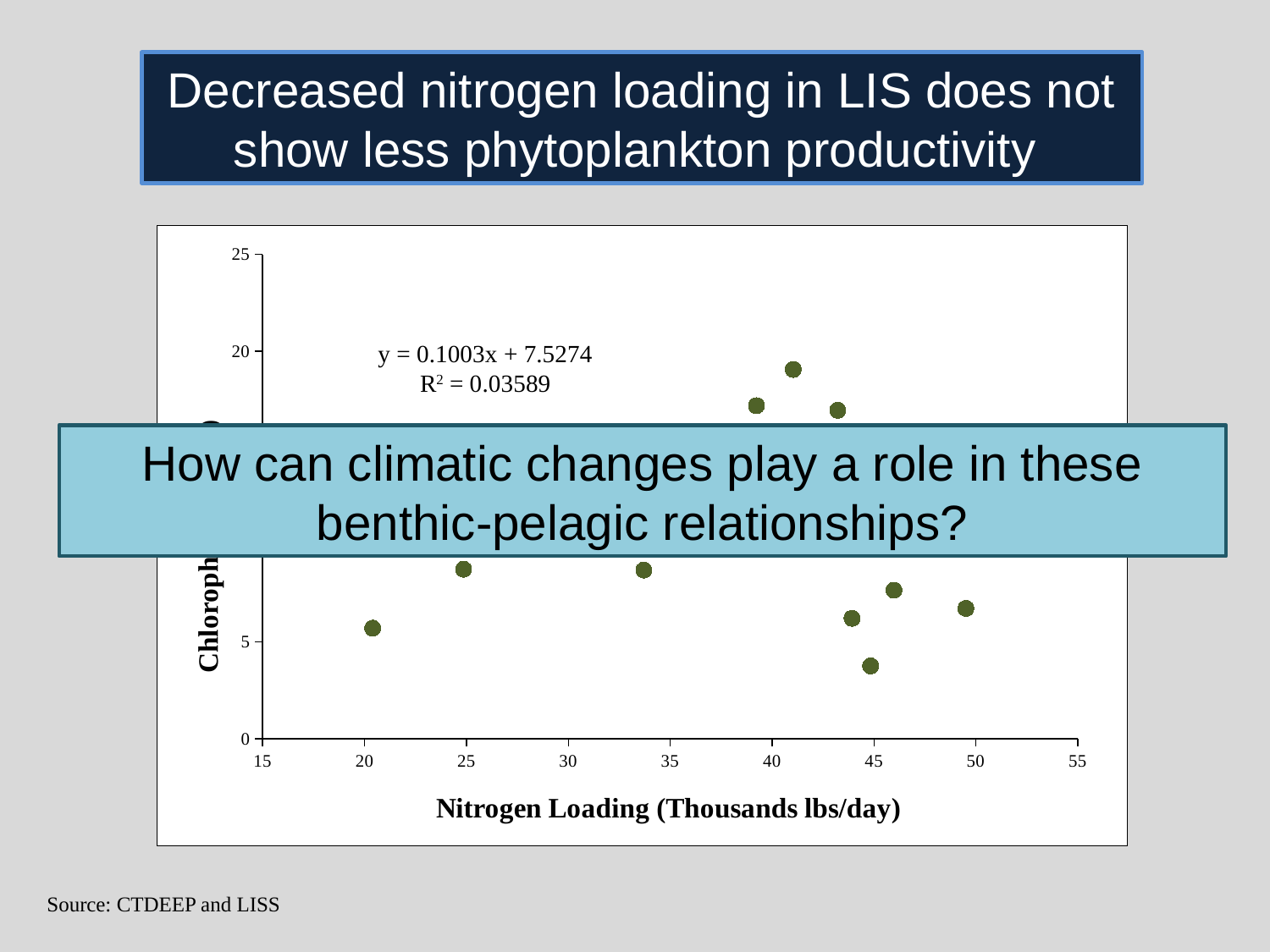
What is the label of the x axis of the chart? Nitrogen Loading (Thousands lbs/day) Is the chlorophyll value for the point at a nitrogen loading of about 45 thousand lbs/day (the lowest point) greater or less than 5? less What R² value is printed on the chart? 0.03589 According to the trendline equation printed on the chart, is the slope positive or negative? positive Is the chlorophyll value for the point at a nitrogen loading of about 49.5 thousand lbs/day greater or less than 5? greater Is the chlorophyll value for the point at a nitrogen loading of about 41 thousand lbs/day greater or less than 15? greater Which has the higher chlorophyll value: the point at about 41 thousand lbs/day or the point at about 45 thousand lbs/day? the point at about 41 thousand lbs/day What is the highest value shown on the x axis of the chart? 55 What trendline equation is printed on the chart? y = 0.1003x + 7.5274 What kind of chart is shown on the slide? scatter plot